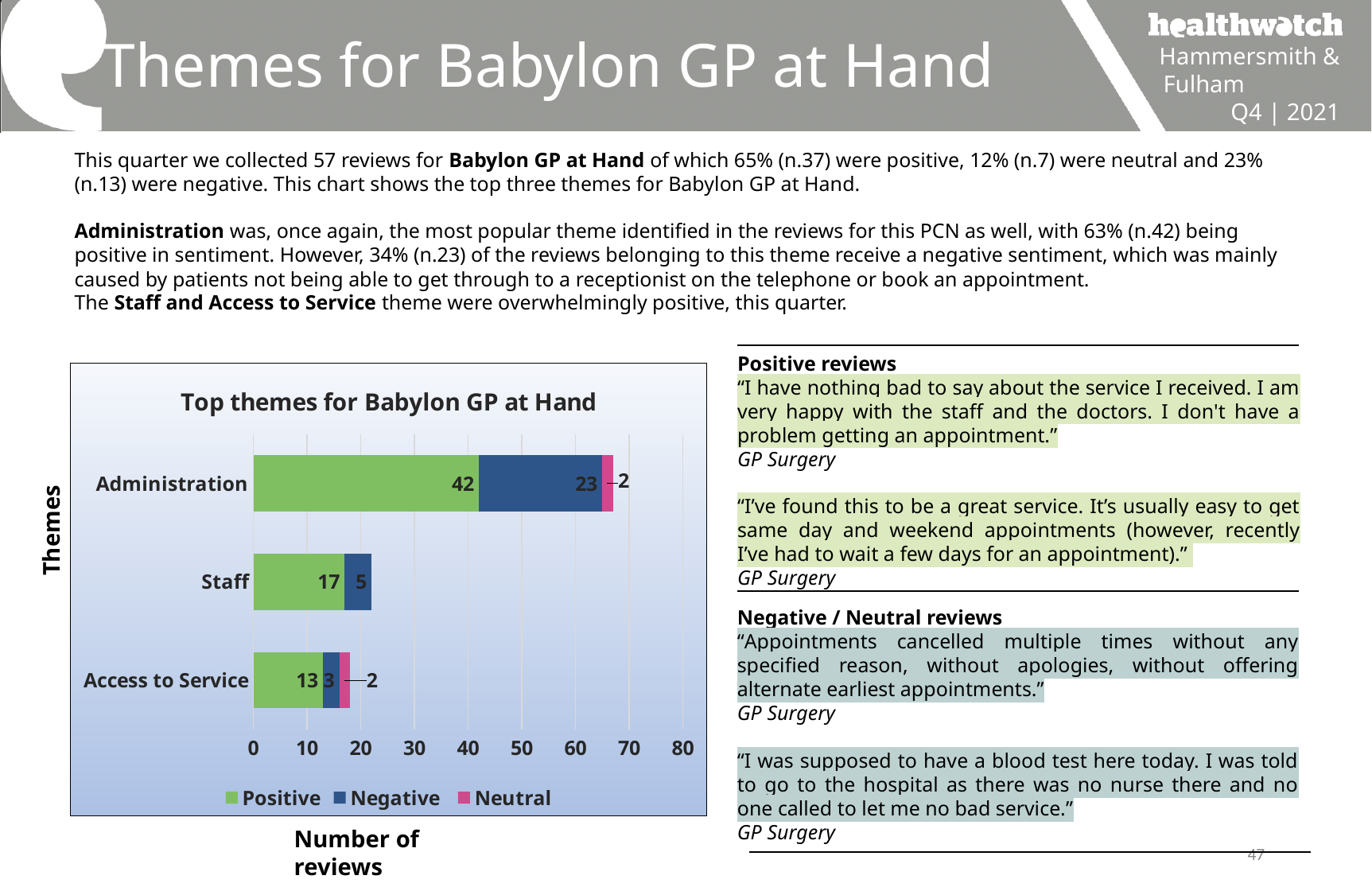
What is the total of the stacked bar for Administration? 67 What is the Negative value for Staff? 5 Which theme has the highest Positive value? Administration How many themes are shown on the chart? 3 How many series does the legend list? 3 What is the Positive value for Administration? 42 Is the total length of the Administration bar greater or less than 60? greater What kind of chart is shown? Stacked bar chart Which is larger, the Negative value for Staff or the Negative value for Access to Service? Staff Which theme has the lowest Positive value? Access to Service What is the difference between the Positive and Negative values for Administration? 19 What is the Neutral value for Access to Service? 2